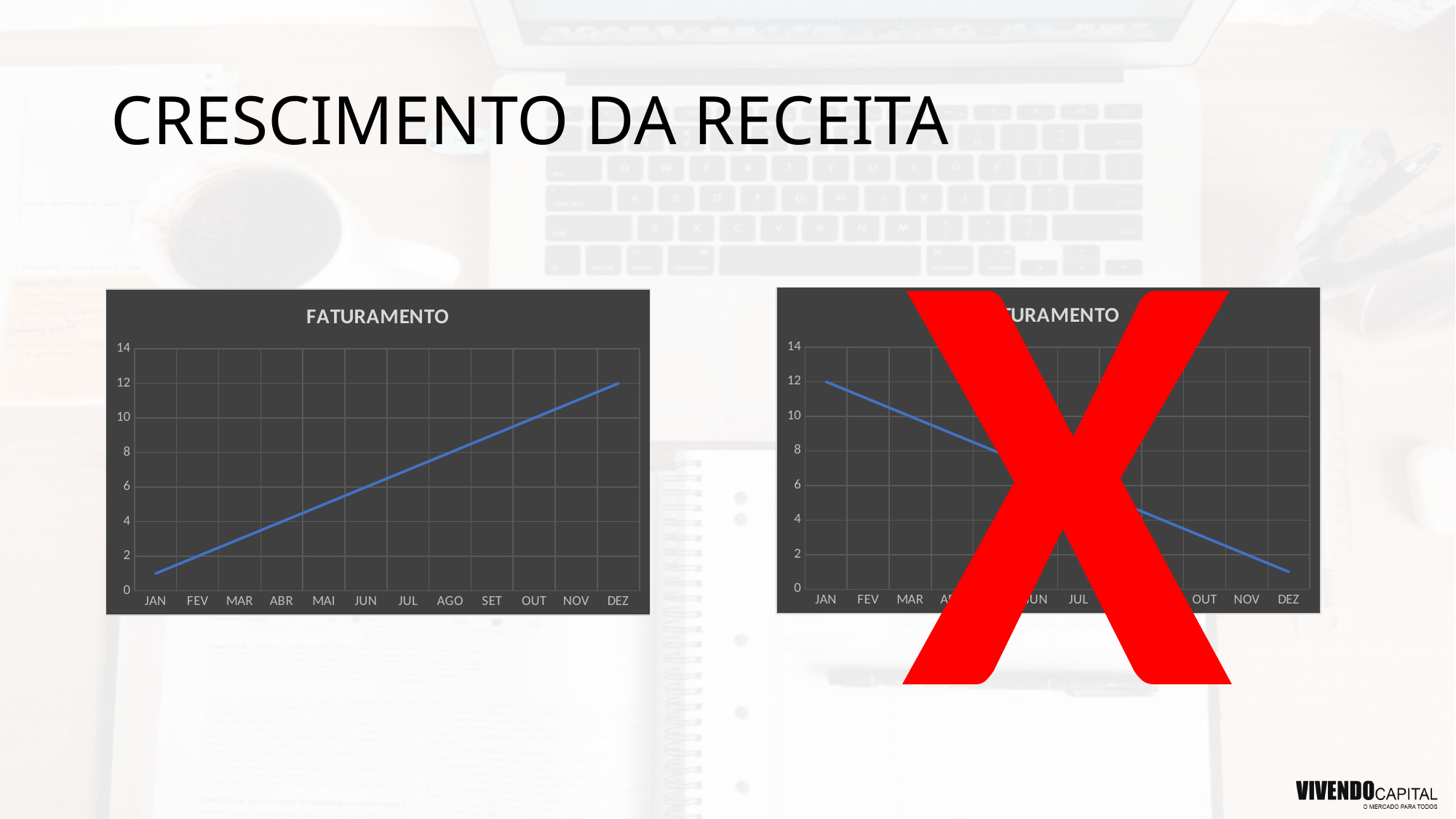
What is the title of the left chart? FATURAMENTO In the left chart, is the value for MAR greater or less than 6? less In the right chart, which month has the lowest value? DEZ In the left chart, which month has the lowest value? JAN In the left chart, what is the value for DEZ? 12 In the right chart, do the values rise or fall from JAN to DEZ? fall In the right chart, what is the value for JAN? 12 What kind of chart is the left chart on the slide? line chart In the left chart, which month has the highest value? DEZ In the left chart, is the value for NOV greater or less than 10? greater How many months are shown on the x axis of the left chart? 12 In the left chart, do the values rise or fall from JAN to DEZ? rise